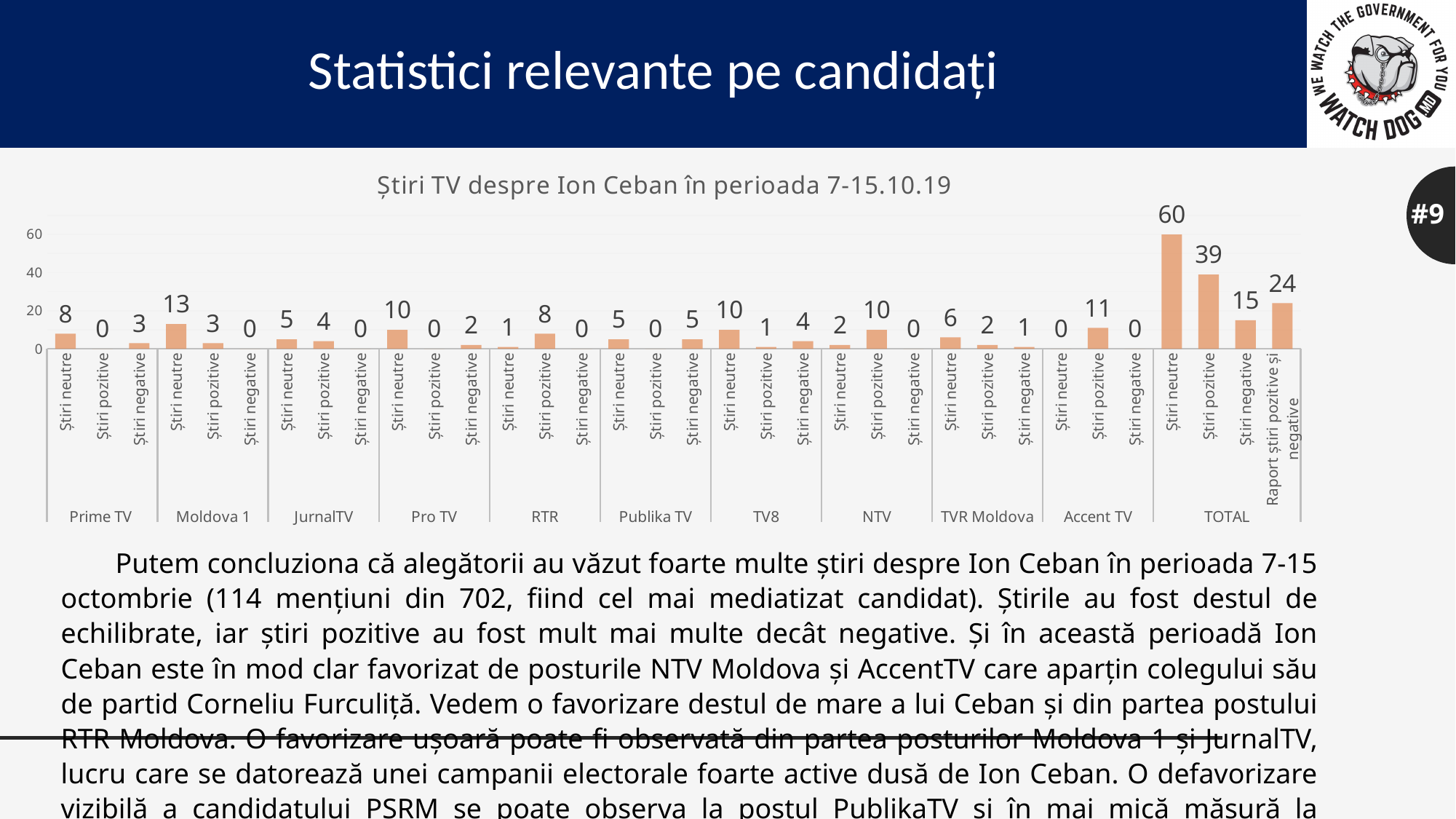
What kind of chart is shown on the slide? Bar chart What is the value for Știri neutre at Moldova 1? 13 What is the title of the chart? Știri TV despre Ion Ceban în perioada 7-15.10.19 Is the value for Știri neutre in the TOTAL group greater or less than 40? greater What is the value for Știri pozitive in the TOTAL group? 39 How many TV station groups (including TOTAL) are shown on the x axis? 11 What is the value for Știri negative at Publika TV? 5 Which is larger at NTV: Știri neutre or Știri pozitive? Știri pozitive What is the value for Știri pozitive at RTR? 8 Which TV station has the highest value for Știri neutre (excluding TOTAL)? Moldova 1 What is the difference between Știri neutre and Știri negative in the TOTAL group? 45 What is the value for Știri pozitive at Accent TV? 11